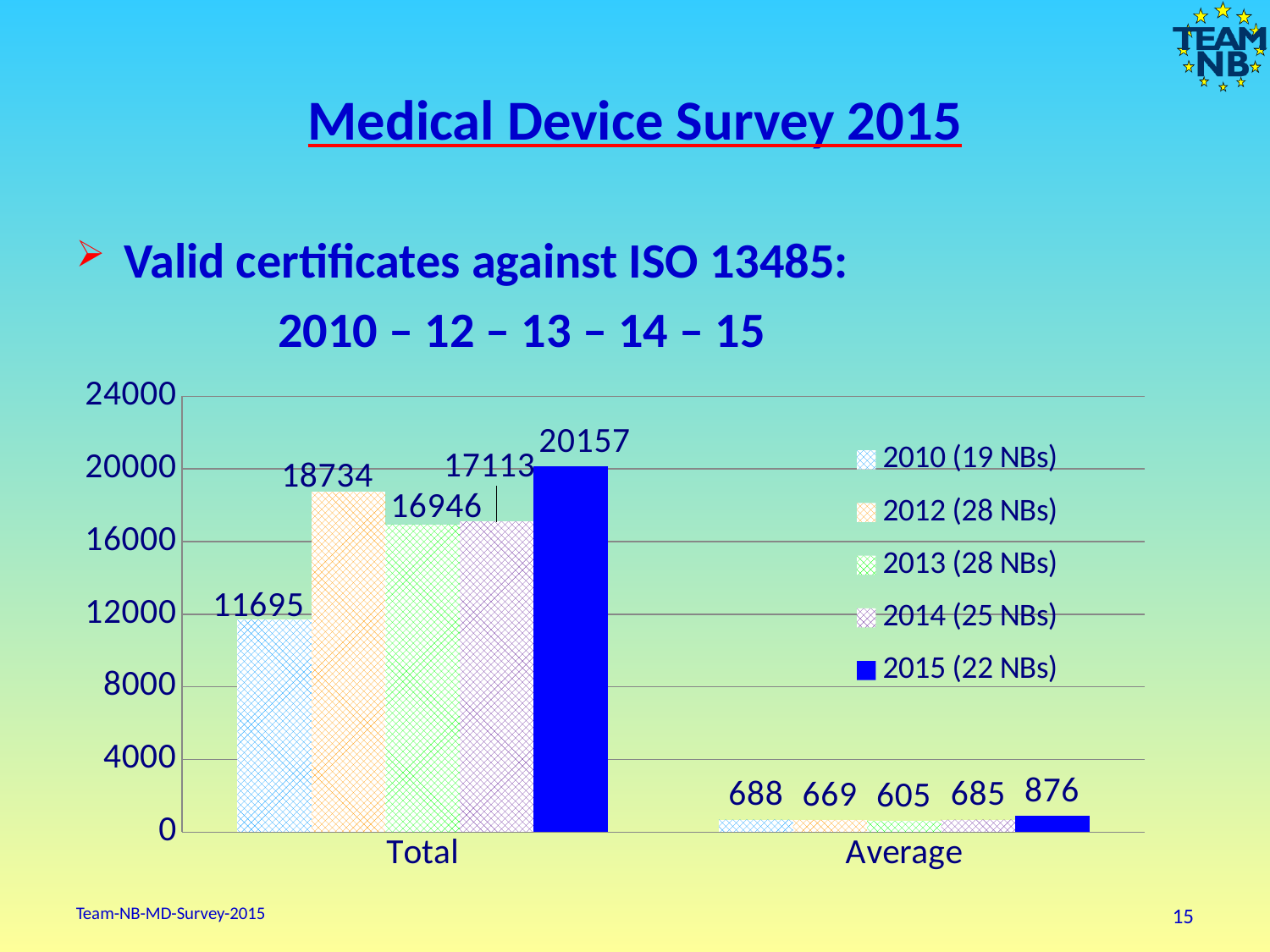
What is the difference between the Average values for 2015 (22 NBs) and 2012 (28 NBs)? 207 How many categories are shown on the x axis? 2 How many series does the legend list? 5 Which series has the highest Total value? 2015 (22 NBs) Which is larger, the Total value for 2012 (28 NBs) or for 2014 (25 NBs)? 2012 (28 NBs) What is the difference between the Total values for 2015 (22 NBs) and 2010 (19 NBs)? 8462 What kind of chart is shown on the slide? bar chart What is the Total value for 2015 (22 NBs)? 20157 What is the Total value for 2010 (19 NBs)? 11695 Is the Total value for 2013 (28 NBs) greater or less than 16000? greater Which series has the lowest Average value? 2013 (28 NBs) What is the Average value for 2013 (28 NBs)? 605